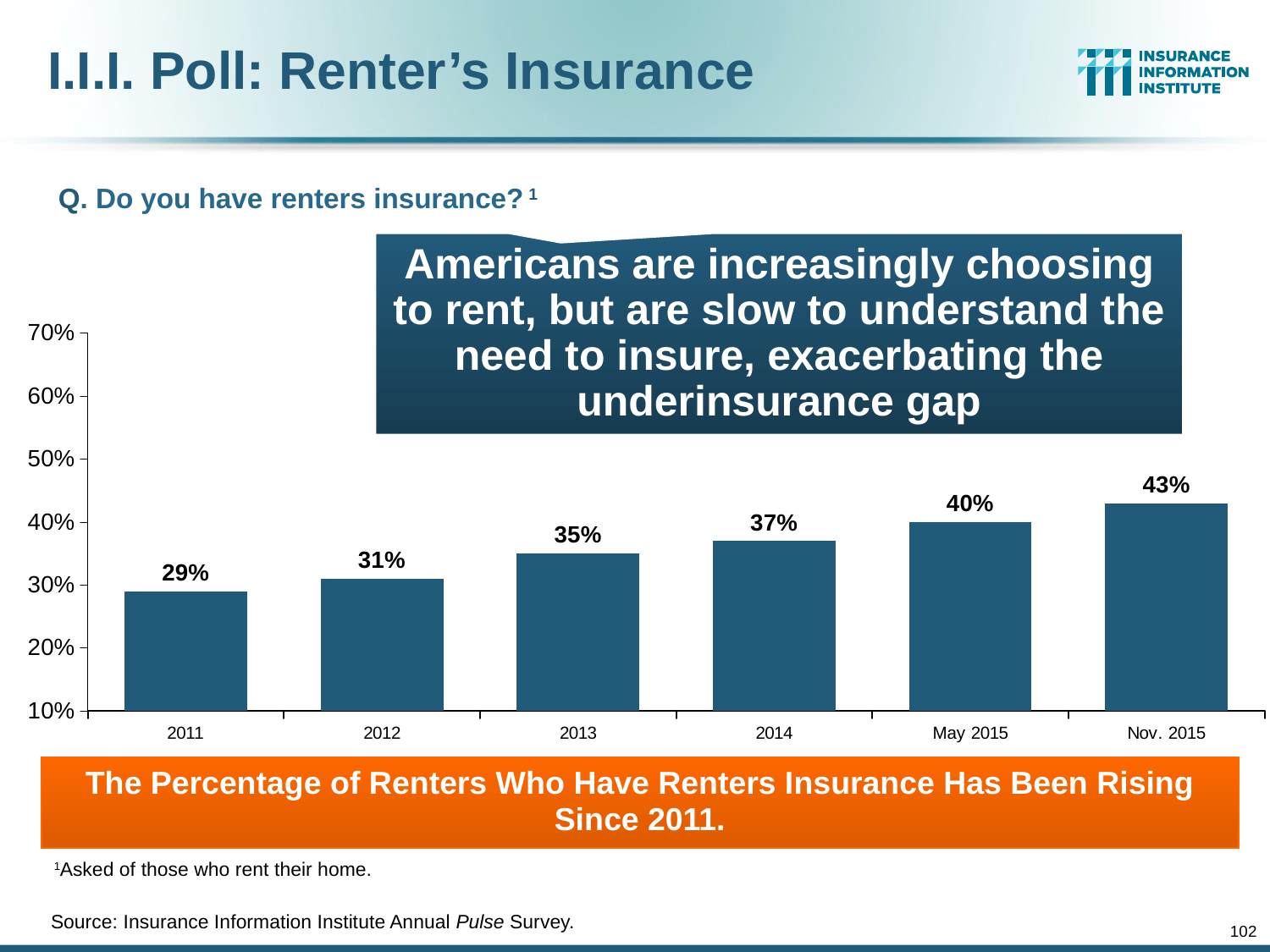
Which is larger, the value for 2013 or the value for May 2015? May 2015 By how many percentage points did the value increase from 2011 to Nov. 2015? 14 percentage points What percentage of renters had renters insurance in 2011? 29% How many periods are shown on the x axis of the chart? 6 What is the value shown for 2013? 35% Which period has the lowest percentage of renters with renters insurance? 2011 What is the value shown for May 2015? 40% What is the value shown for Nov. 2015? 43% What is the difference between the 2014 value and the 2012 value? 6 percentage points Do the values rise or fall from 2011 to Nov. 2015? Rise Which period has the highest percentage of renters with renters insurance? Nov. 2015 What kind of chart is shown on the slide? Bar chart